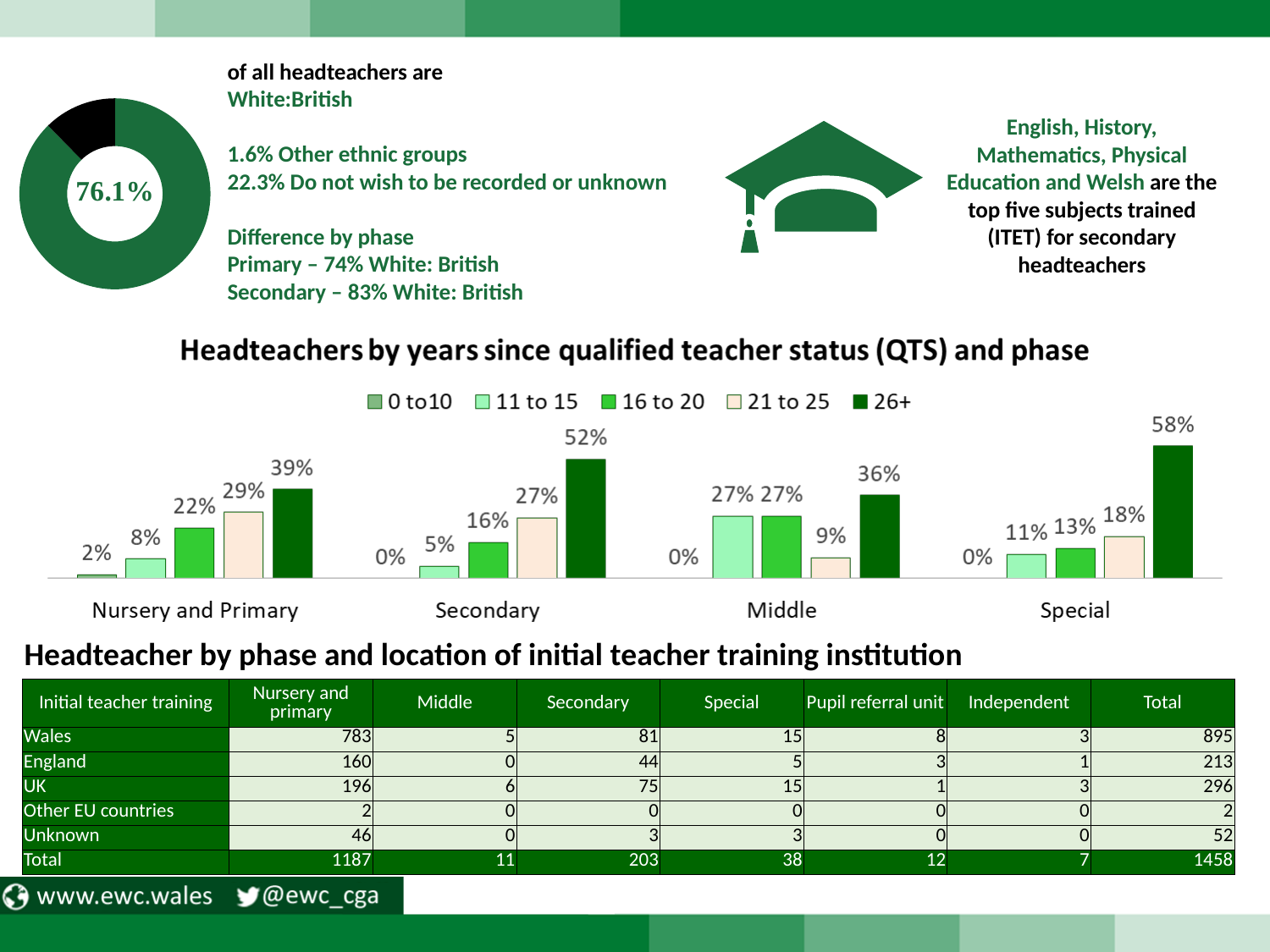
How many series does the legend of the 'Headteachers by years since qualified teacher status (QTS) and phase' chart list? 5 In the 'Headteachers by years since qualified teacher status (QTS) and phase' chart, do the values for Nursery and Primary rise or fall from the 0 to10 series to the 26+ series? Rise What kind of chart is 'Headteachers by years since qualified teacher status (QTS) and phase'? Bar chart In the 'Headteachers by years since qualified teacher status (QTS) and phase' chart, what is the value for the 16 to 20 series for Nursery and Primary? 22% What percentage is shown in the centre of the donut chart at the top left of the slide? 76.1% In the 'Headteachers by years since qualified teacher status (QTS) and phase' chart, what is the value for the 21 to 25 series for Middle? 9% In the 'Headteachers by years since qualified teacher status (QTS) and phase' chart, which phase has the lowest value for the 11 to 15 series? Secondary In the 'Headteachers by years since qualified teacher status (QTS) and phase' chart, what is the difference between the 26+ value for Special and the 26+ value for Nursery and Primary? 19% In the 'Headteachers by years since qualified teacher status (QTS) and phase' chart, what is the value for the 26+ series for Secondary? 52% In the 'Headteachers by years since qualified teacher status (QTS) and phase' chart, which phase has the highest value for the 26+ series? Special How many phases are shown on the x axis of the 'Headteachers by years since qualified teacher status (QTS) and phase' chart? 4 In the 'Headteachers by years since qualified teacher status (QTS) and phase' chart, which is larger: the 21 to 25 value for Secondary or the 21 to 25 value for Special? Secondary